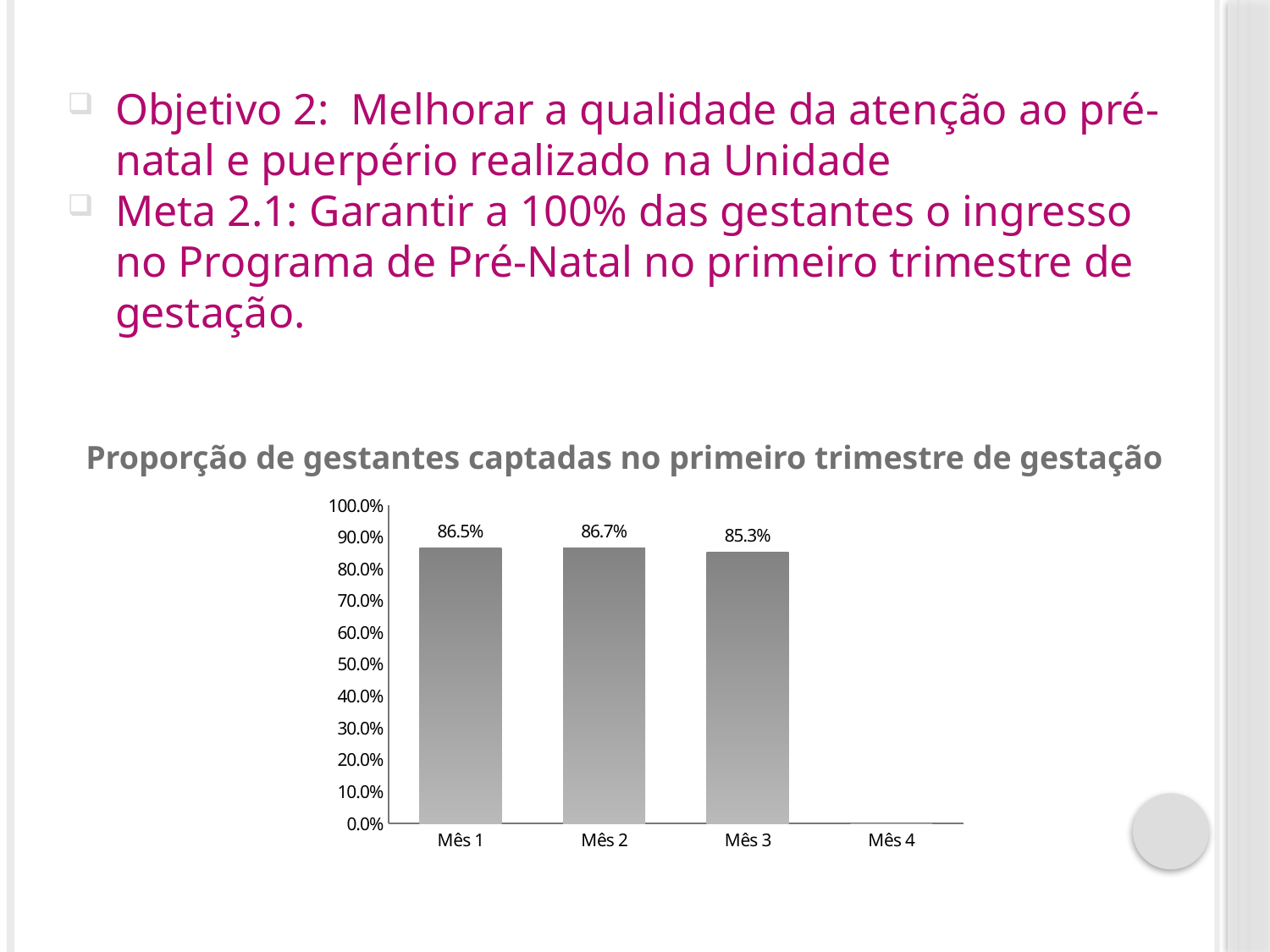
What kind of chart is shown on the slide? Bar chart Among Mês 1, Mês 2 and Mês 3, which month has the lowest proportion? Mês 3 What is the difference between the values for Mês 1 and Mês 3? 1.2 percentage points How many categories are shown on the x axis of the chart? 4 Is the value for Mês 3 greater or less than 80.0%? greater Which is larger, the value for Mês 1 or the value for Mês 3? Mês 1 What is the difference between the values for Mês 2 and Mês 1? 0.2 percentage points What is the value for Mês 1 in the chart? 86.5% Which month has the highest proportion in the chart? Mês 2 What is the value for Mês 3 in the chart? 85.3% What is the title of the chart? Proporção de gestantes captadas no primeiro trimestre de gestação What is the value for Mês 2 in the chart? 86.7%